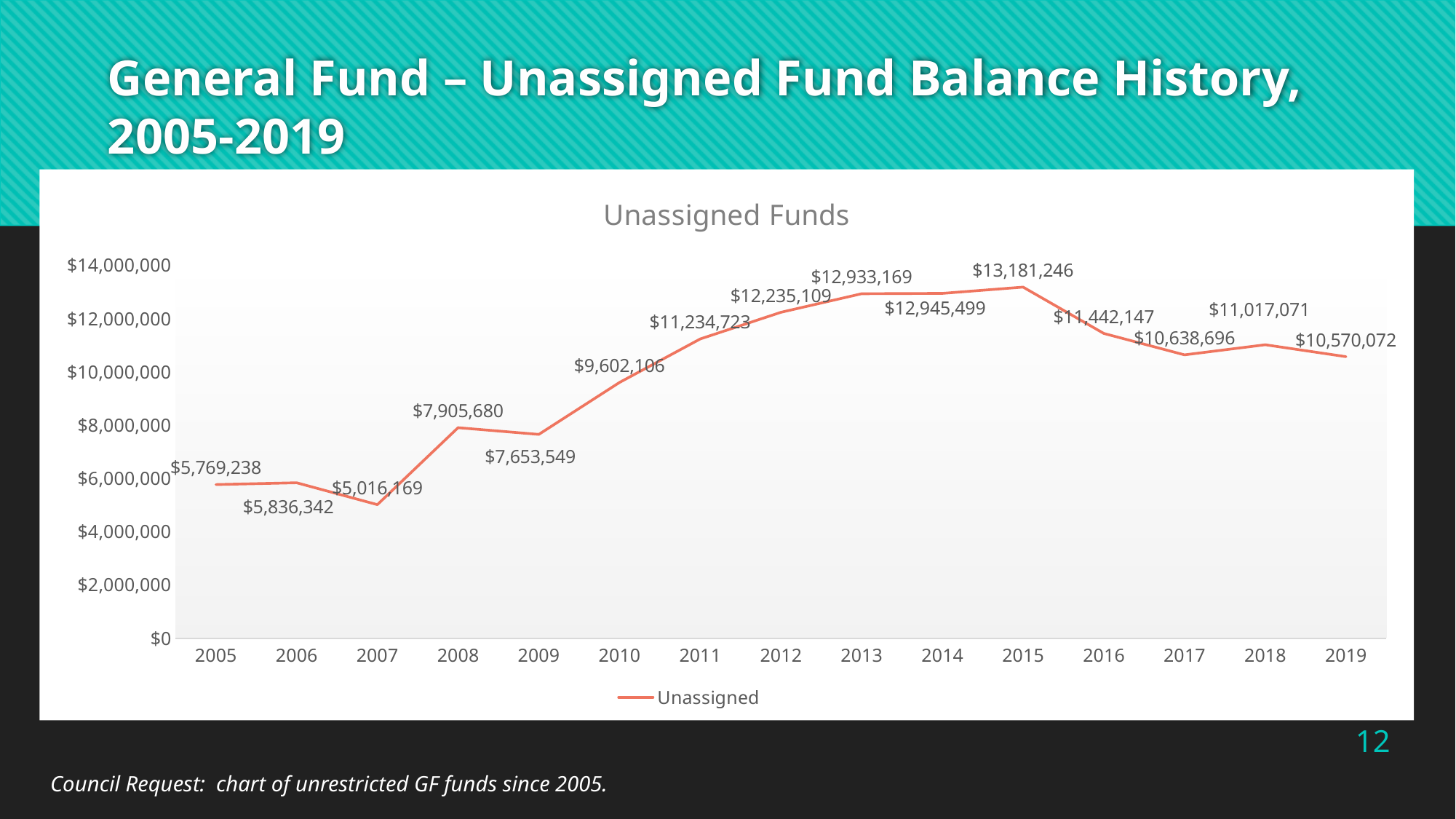
What is the unassigned fund balance for 2010? $9,602,106 How many years are plotted on the chart? 15 Which year has the lowest unassigned fund balance? 2007 What kind of chart is shown on the slide? Line chart What is the unassigned fund balance for 2019? $10,570,072 Which year has a larger unassigned fund balance, 2008 or 2009? 2008 What is the unassigned fund balance for 2015? $13,181,246 What is the unassigned fund balance for 2007? $5,016,169 Is the unassigned fund balance for 2011 greater or less than $10,000,000? greater Which year has the highest unassigned fund balance? 2015 What is the title of the chart? Unassigned Funds What is the difference between the unassigned fund balance in 2015 and in 2019? $2,611,174